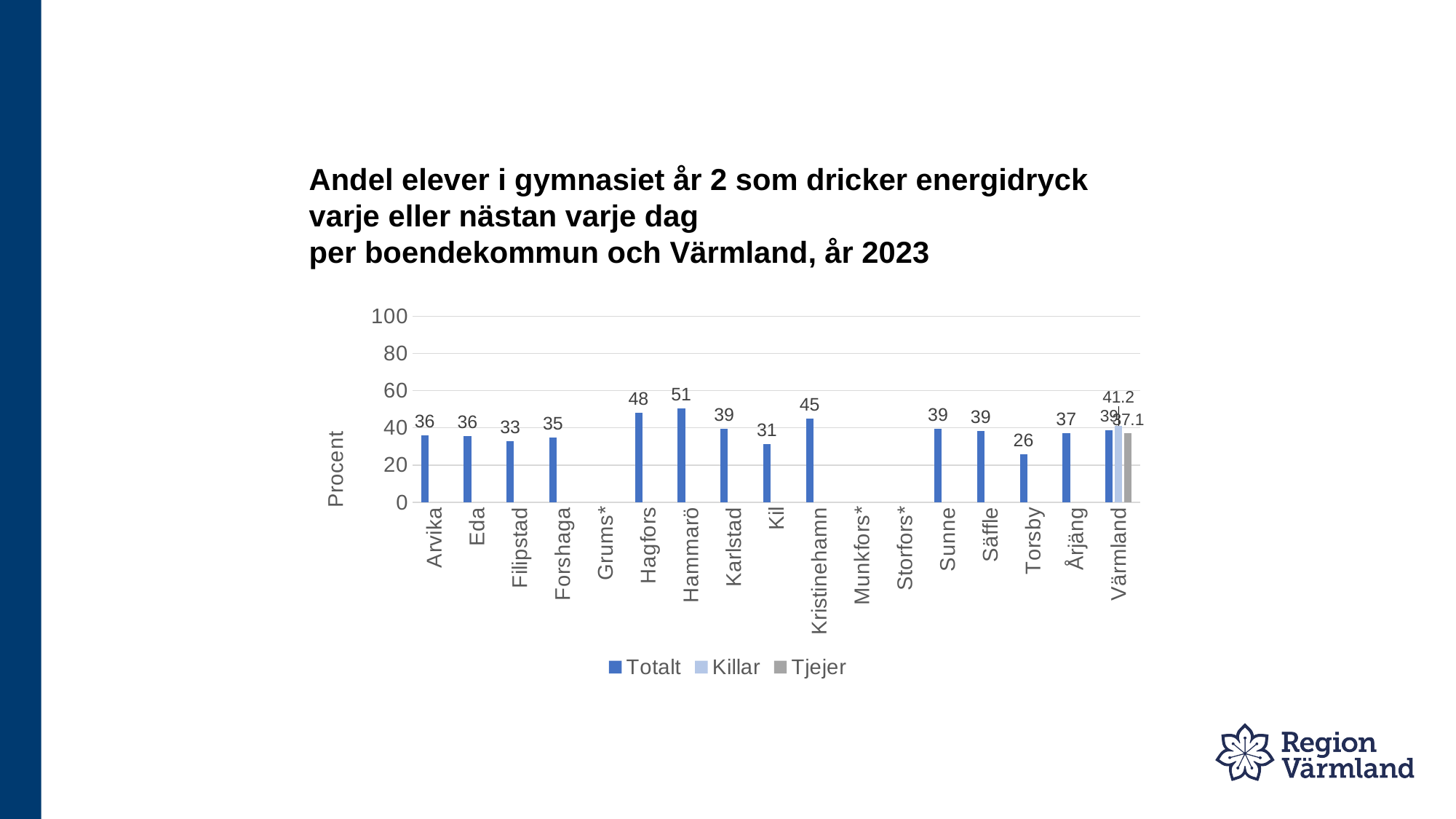
Which municipality has the lowest plotted Totalt value? Torsby What is the Totalt value for Hammarö? 51 How many categories are shown on the x axis? 17 What kind of chart is shown on the slide? Bar chart What is the difference between the Totalt values for Hagfors and Torsby? 22 What is the Tjejer value for Värmland? 37.1 What is the Killar value for Värmland? 41.2 Which municipality has the highest Totalt value? Hammarö What is the difference between the Killar and Tjejer values for Värmland? 4.1 What is the label on the y axis? Procent How many series does the legend list? 3 Which has a higher Totalt value, Kristinehamn or Karlstad? Kristinehamn